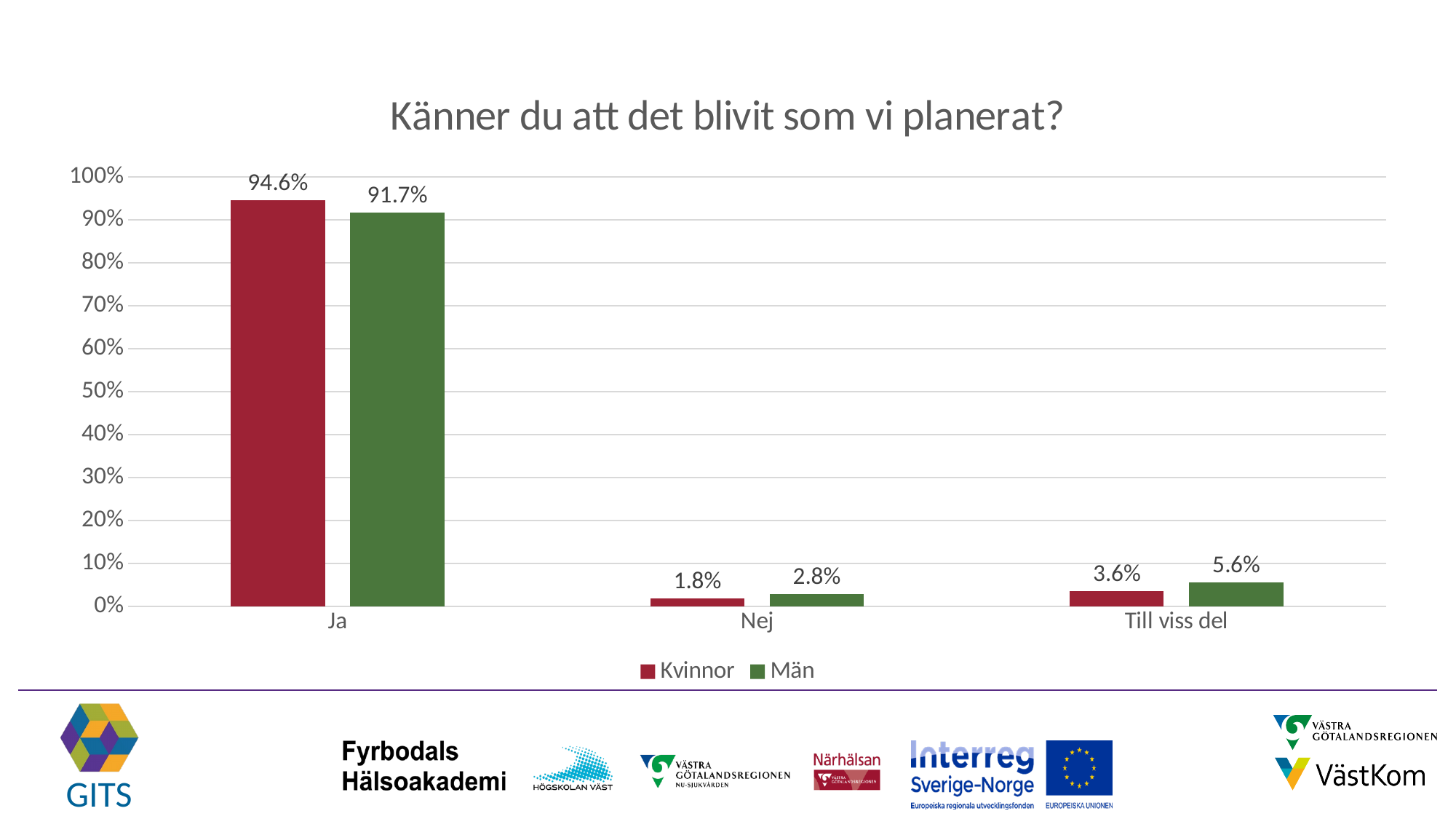
Which category has the highest value for Kvinnor? Ja Which category has the lowest value for Män? Nej What is the difference between the Kvinnor and Män values in the Ja category? 2.9% Is the value for Män in the Ja category greater or less than 90%? greater What is the value for Män in the Till viss del category? 5.6% How many categories are shown on the x axis? 3 What kind of chart is shown on the slide? Bar chart What is the value for Kvinnor in the Ja category? 94.6% What is the value for Män in the Ja category? 91.7% In the Till viss del category, which series has the larger value, Kvinnor or Män? Män What is the value for Kvinnor in the Nej category? 1.8% How many series does the legend list? 2